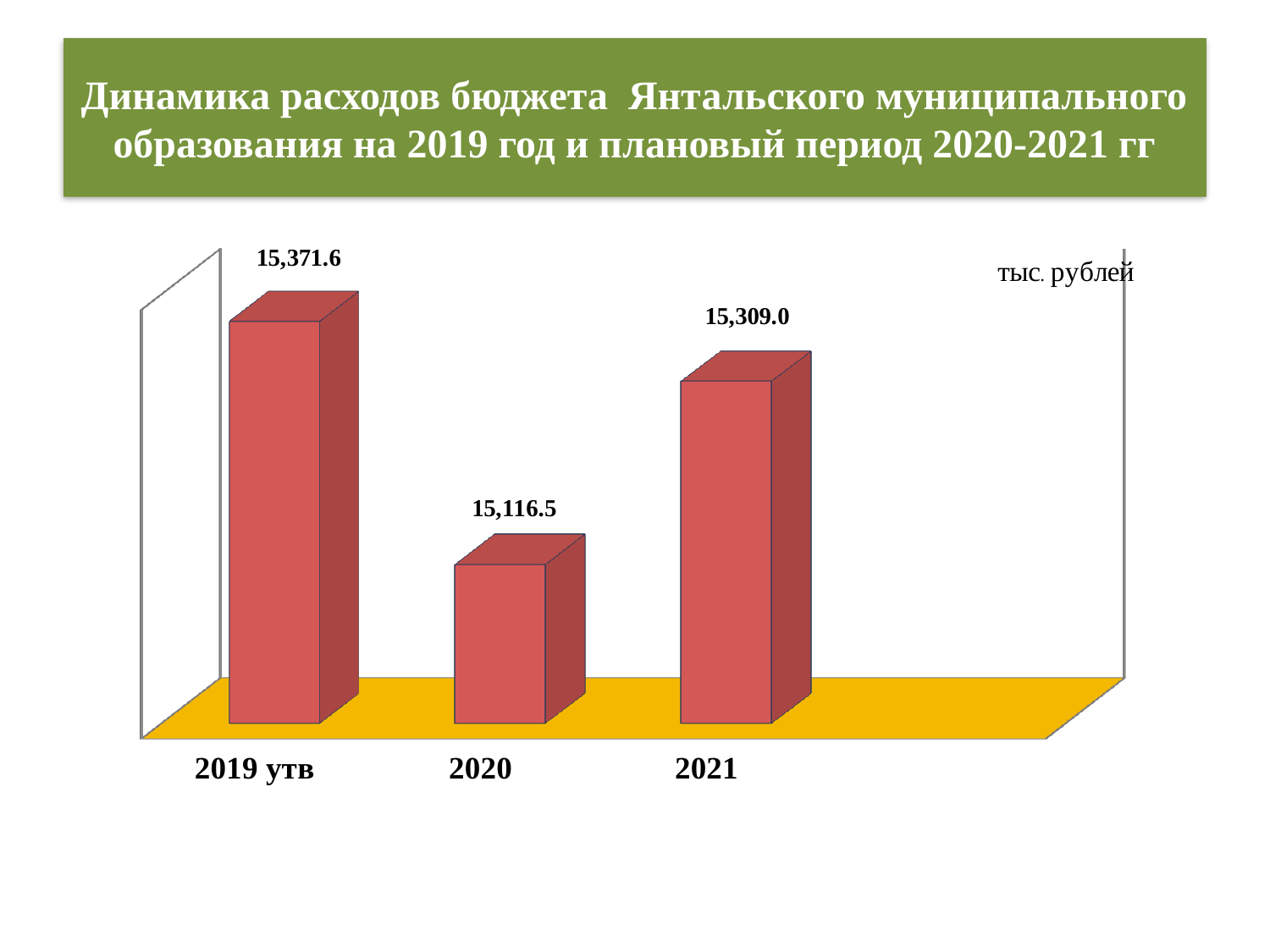
Which category has the highest value? 2019 утв What is the value for 2019 утв? 15,371.6 How many categories are shown on the x axis? 3 Which category has the lowest value? 2020 What is the difference between the values for 2021 and 2020? 192.5 What unit is indicated for the values on the chart? тыс. рублей What is the difference between the values for 2019 утв and 2020? 255.1 What kind of chart is shown on the slide? bar chart Which is larger, the value for 2019 утв or the value for 2021? 2019 утв Does the value rise or fall from 2019 утв to 2020? fall What is the value for 2020? 15,116.5 What is the value for 2021? 15,309.0